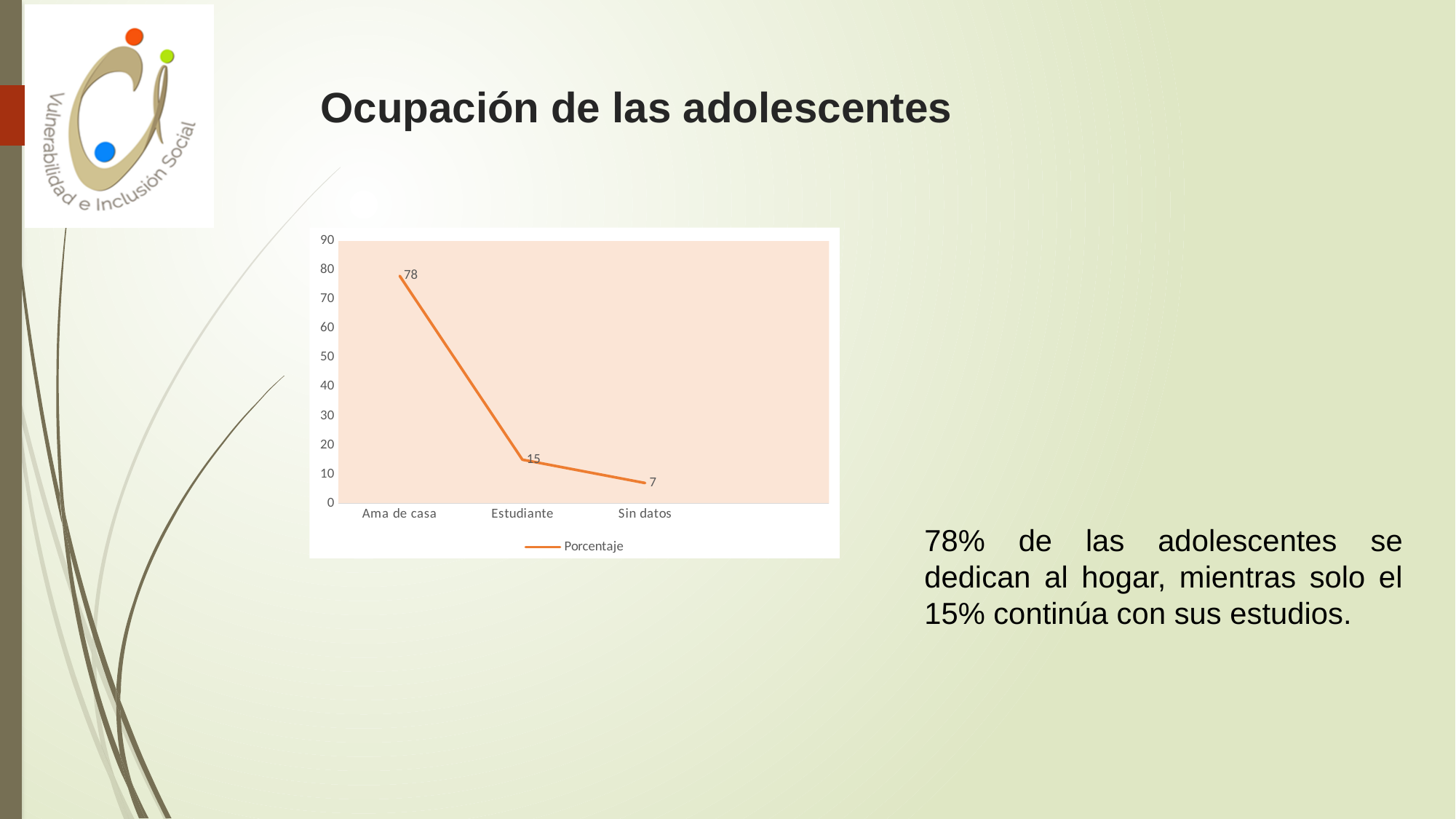
Which is larger, the value for Estudiante or the value for Sin datos? Estudiante Which category has the highest value? Ama de casa Do the values rise or fall from Ama de casa to Sin datos? fall What kind of chart is shown on the slide? line chart What is the difference between the values for Estudiante and Sin datos? 8 What is the difference between the values for Ama de casa and Estudiante? 63 What is the value for Ama de casa? 78 How many categories are shown on the x axis? 3 Which category has the lowest value? Sin datos Is the value for Ama de casa greater or less than 70? greater What is the value for Sin datos? 7 What is the value for Estudiante? 15